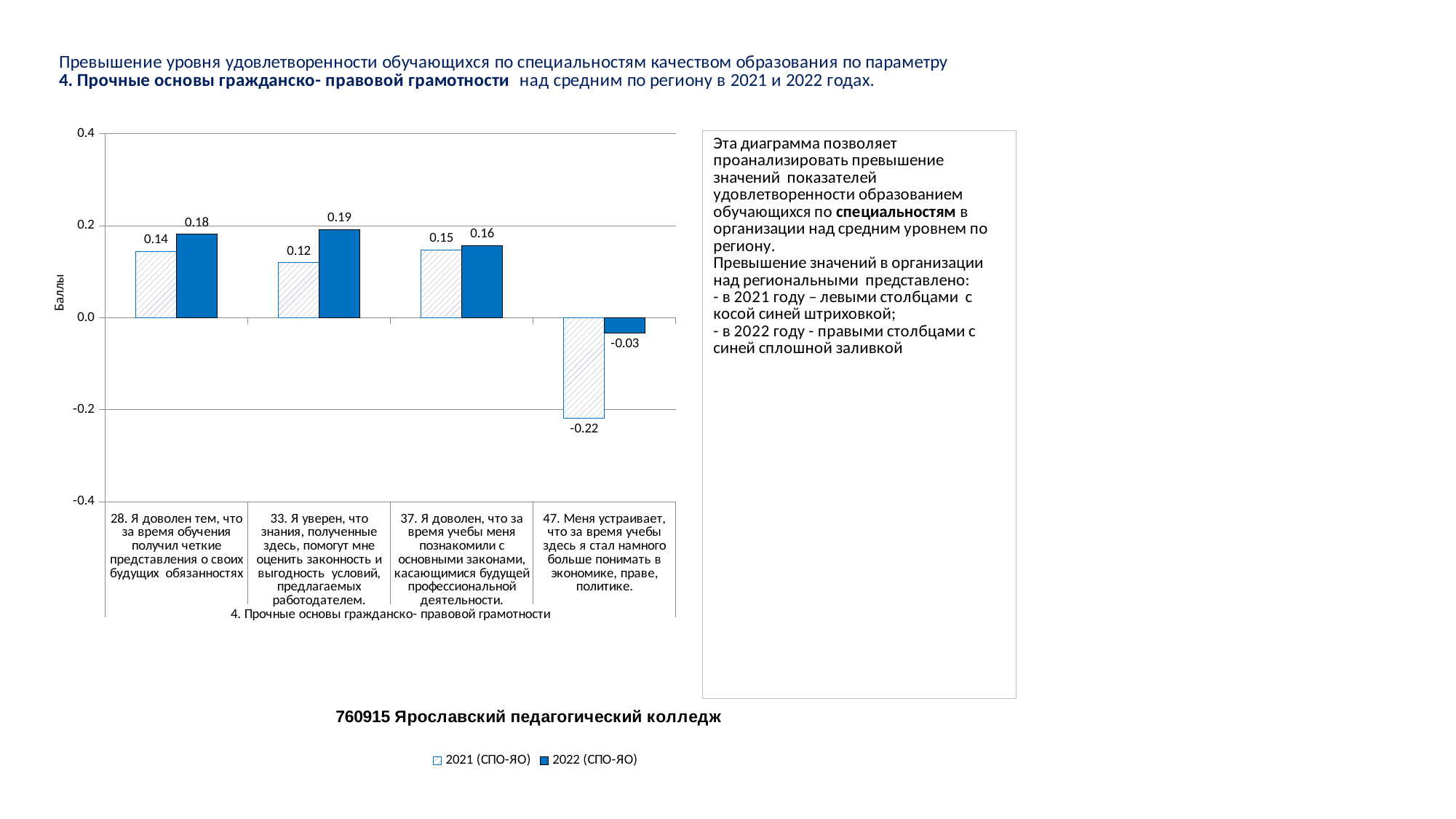
What is the 2022 (СПО-ЯО) value for category 33 ("Я уверен, что знания, полученные здесь, помогут мне оценить законность и выгодность условий, предлагаемых работодателем")? 0.19 What is the 2021 (СПО-ЯО) value for category 47 ("Меня устраивает, что за время учебы здесь я стал намного больше понимать в экономике, праве, политике")? -0.22 What is the difference between the 2022 and 2021 values for category 33? 0.07 What is the difference between the 2022 and 2021 values for category 47? 0.19 Is the 2021 value for category 47 greater or less than -0.2? less Which category has the highest 2022 (СПО-ЯО) value? 33. Я уверен, что знания, полученные здесь, помогут мне оценить законность и выгодность условий, предлагаемых работодателем. Which category has the lowest 2021 (СПО-ЯО) value? 47. Меня устраивает, что за время учебы здесь я стал намного больше понимать в экономике, праве, политике. What kind of chart is shown on the slide? bar chart What is the 2021 (СПО-ЯО) value for category 28 ("Я доволен тем, что за время обучения получил четкие представления о своих будущих обязанностях")? 0.14 How many series does the legend list? 2 For category 28, which is larger: the 2021 value or the 2022 value? 2022 How many categories are shown on the x axis? 4